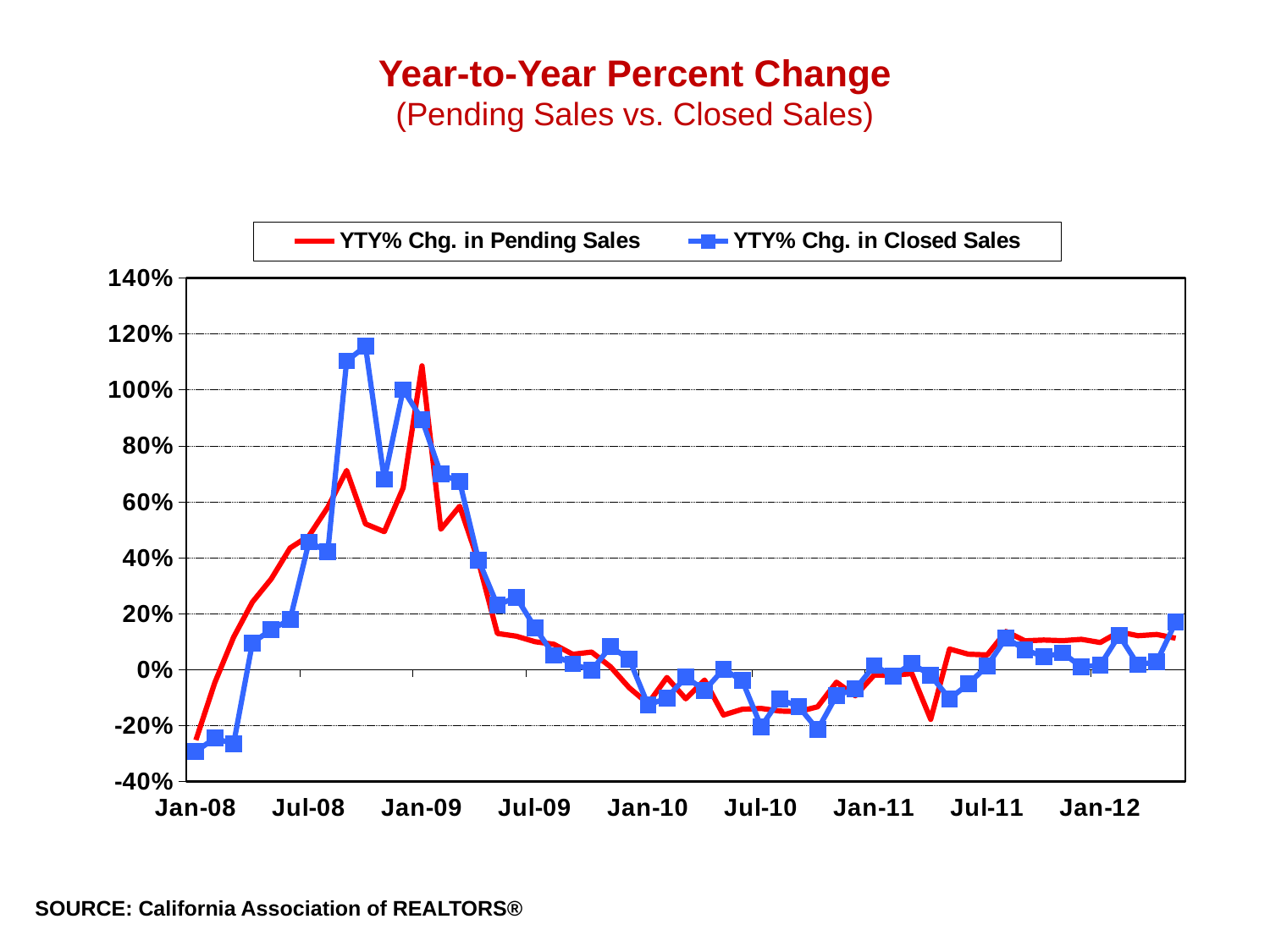
Is the highest value reached by YTY% Chg. in Pending Sales greater or less than 100%? greater What colour is the line for YTY% Chg. in Pending Sales? red How many series does the legend list? 2 Which series reaches the higher peak value, Pending Sales or Closed Sales? YTY% Chg. in Closed Sales Is the value for YTY% Chg. in Closed Sales at Jan-09 greater or less than 80%? greater Between Jan-09 and Jan-10, does YTY% Chg. in Closed Sales generally rise or fall? fall What kind of chart is shown on the slide? line chart Is the value for YTY% Chg. in Closed Sales at Jan-08 greater or less than -20%? less What are the two series named in the legend? YTY% Chg. in Pending Sales and YTY% Chg. in Closed Sales Between Jan-08 and Jul-08, does YTY% Chg. in Pending Sales generally rise or fall? rise